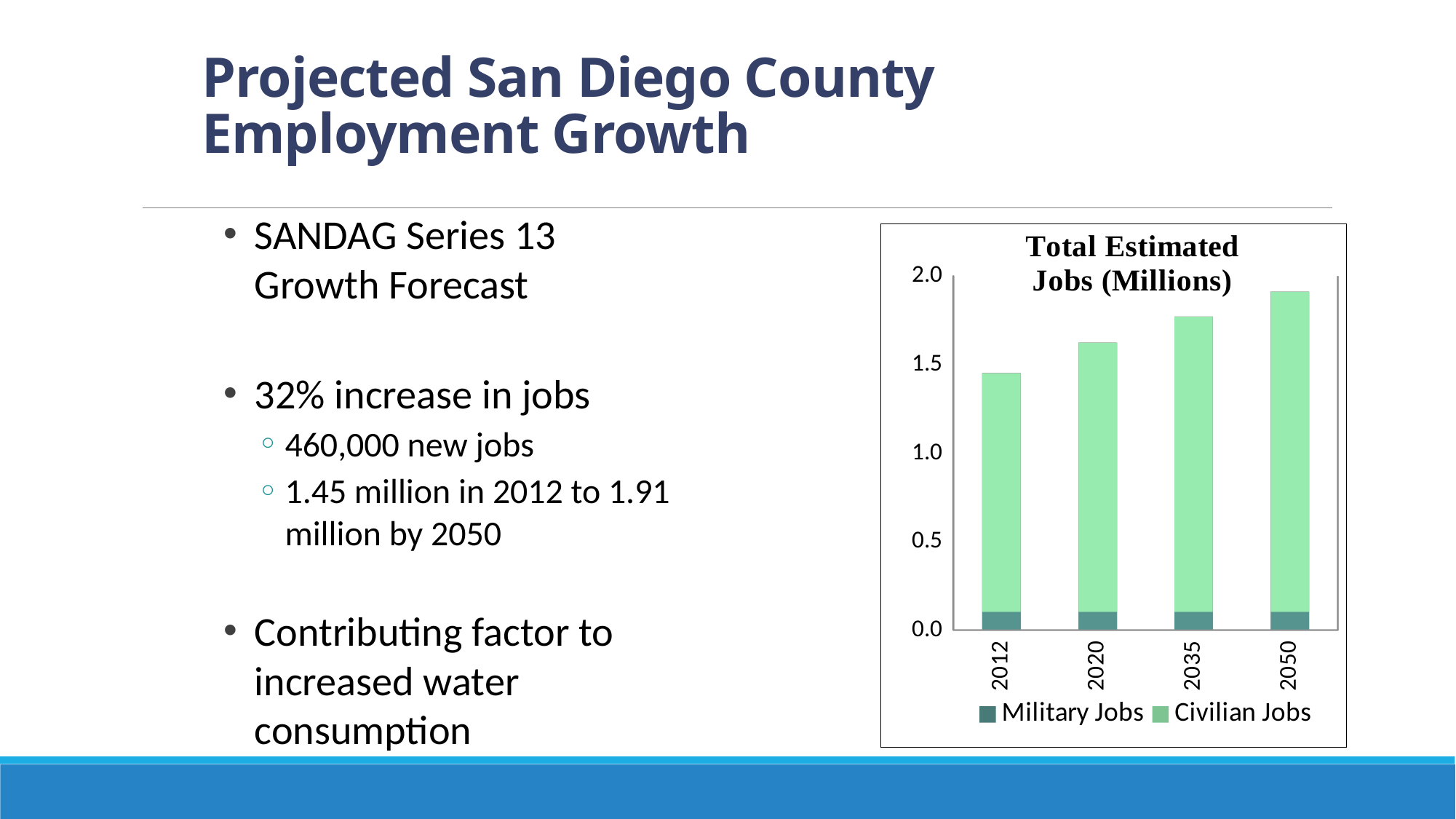
Which year has the lowest total estimated jobs in the chart? 2012 What is the title of the chart? Total Estimated Jobs (Millions) Which year has a taller total bar, 2012 or 2050? 2050 Which two series are listed in the chart legend? Military Jobs and Civilian Jobs How many years are shown on the x axis of the chart? 4 Is the Military Jobs value for 2012 greater or less than 0.5? less Is the total value for 2035 greater or less than 2.0? less Which year has the highest total estimated jobs in the chart? 2050 Do total estimated jobs rise or fall from 2012 to 2050 in the chart? Rise What type of chart is shown on the slide? Stacked bar chart How many series does the chart legend list? 2 Is the total value for 2020 greater or less than 1.5? greater